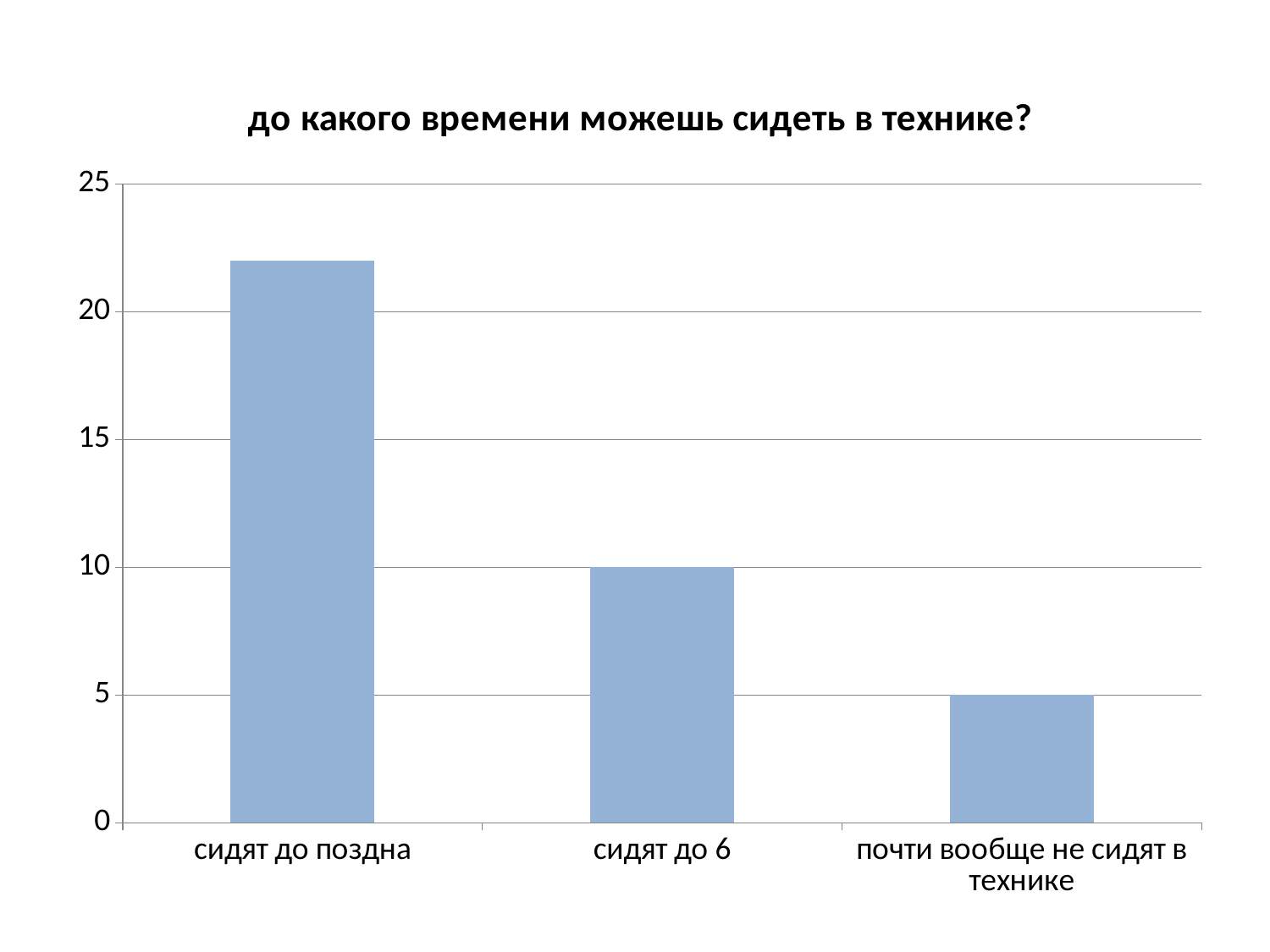
What type of chart is shown on the slide? bar chart Is the value for "сидят до поздна" greater or less than 20? greater Which category has the lowest value? почти вообще не сидят в технике Which category has the highest value? сидят до поздна What is the difference between the values for "сидят до 6" and "почти вообще не сидят в технике"? 5 Is the value for "сидят до поздна" greater or less than 25? less How many categories are shown in the chart? 3 Do the values rise or fall from left to right along the x axis? fall What is the value for "почти вообще не сидят в технике"? 5 What is the title of the chart? до какого времени можешь сидеть в технике? Which is larger, the value for "сидят до поздна" or the value for "сидят до 6"? сидят до поздна What is the value for "сидят до 6"? 10